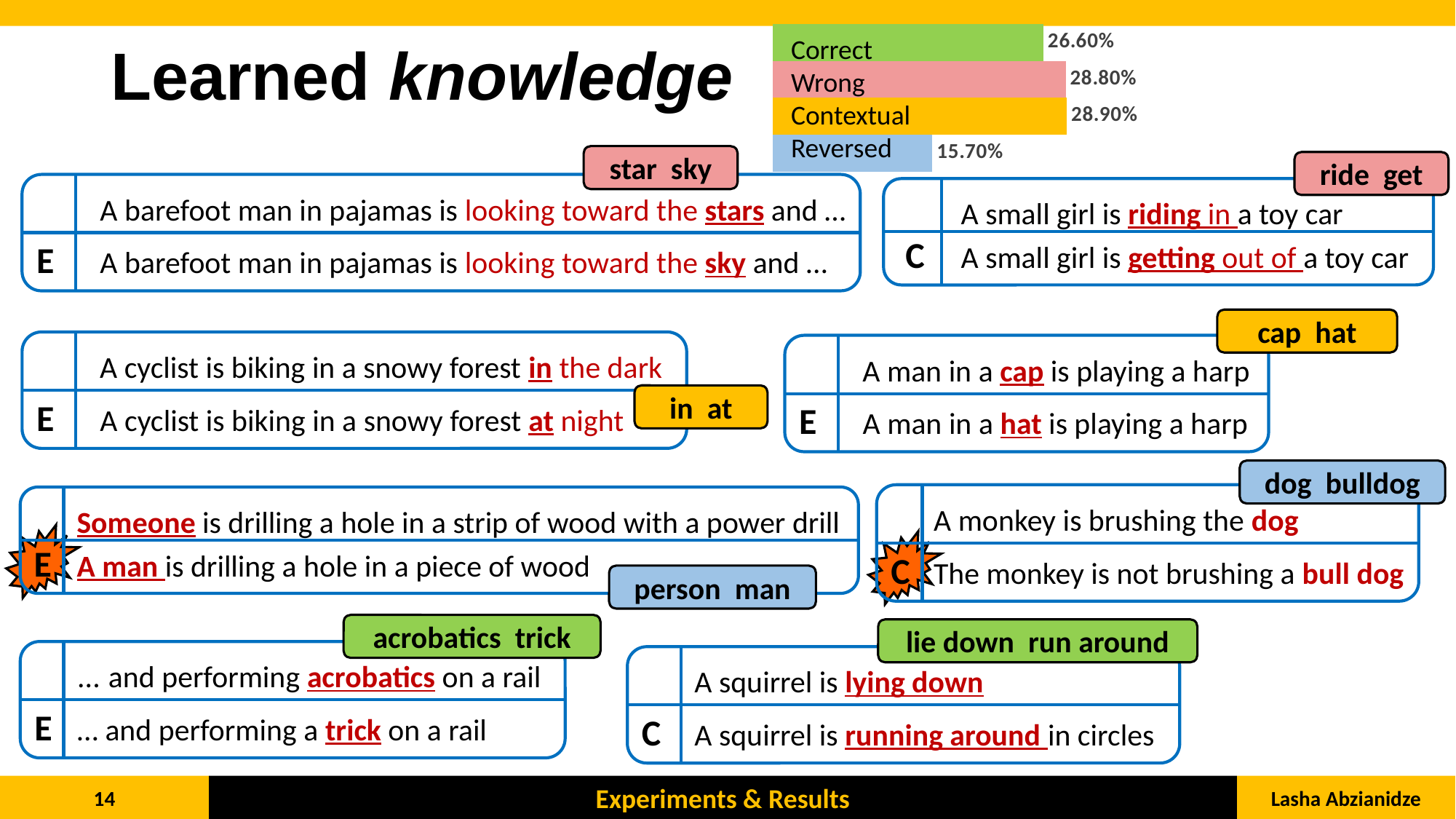
What is the difference between the values for Wrong and Correct in the bar chart? 2.20% Which category has the highest value in the bar chart? Contextual What is the value for Contextual in the bar chart? 28.90% What is the value for Reversed in the bar chart? 15.70% How many categories does the bar chart show? 4 Which category has the lowest value in the bar chart? Reversed What is the difference between the values for Contextual and Reversed in the bar chart? 13.20% What is the value for Wrong in the bar chart? 28.80% Which is larger in the bar chart, the value for Correct or the value for Wrong? Wrong What colour is the Correct bar in the chart? Green What kind of chart is shown at the top of the slide? Bar chart What is the value for Correct in the bar chart? 26.60%